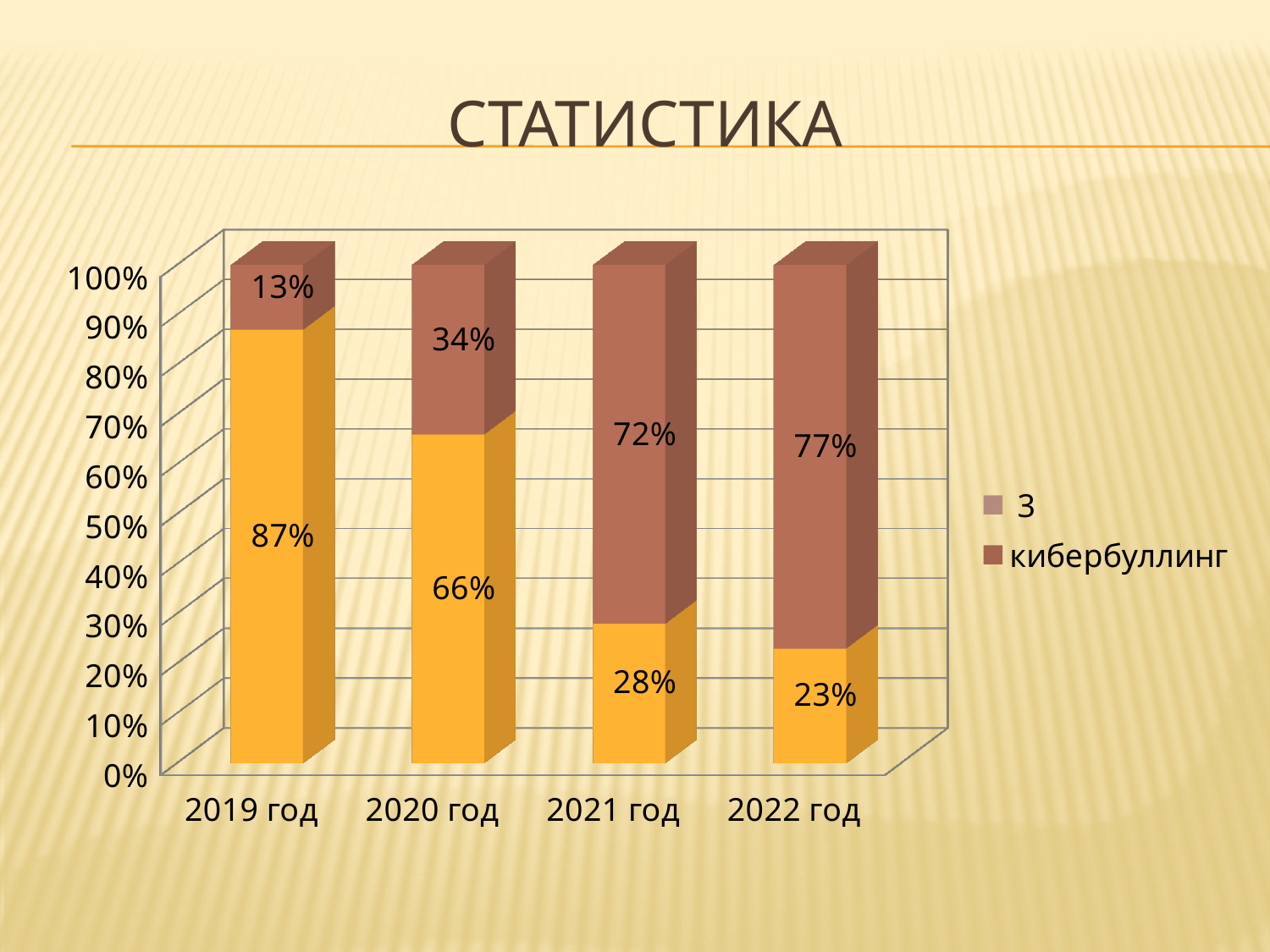
In which year is the кибербуллинг segment the lowest? 2019 год What is the value of the кибербуллинг segment for 2021 год? 72% In which year is the кибербуллинг segment the highest? 2022 год What is the value of the yellow (lower) segment for 2020 год? 66% What is the total of the stacked bar for 2021 год? 100% What is the value of the кибербуллинг segment for 2019 год? 13% For 2020 год, which segment is larger: the кибербуллинг segment or the yellow segment? the yellow segment (66%) What kind of chart is shown on the slide? stacked bar chart By how many percentage points does the кибербуллинг value for 2022 год exceed that for 2019 год? 64% How many series does the legend list? 2 Does the кибербуллинг value rise or fall from 2019 год to 2022 год? rise How many years (categories) are shown on the x axis? 4